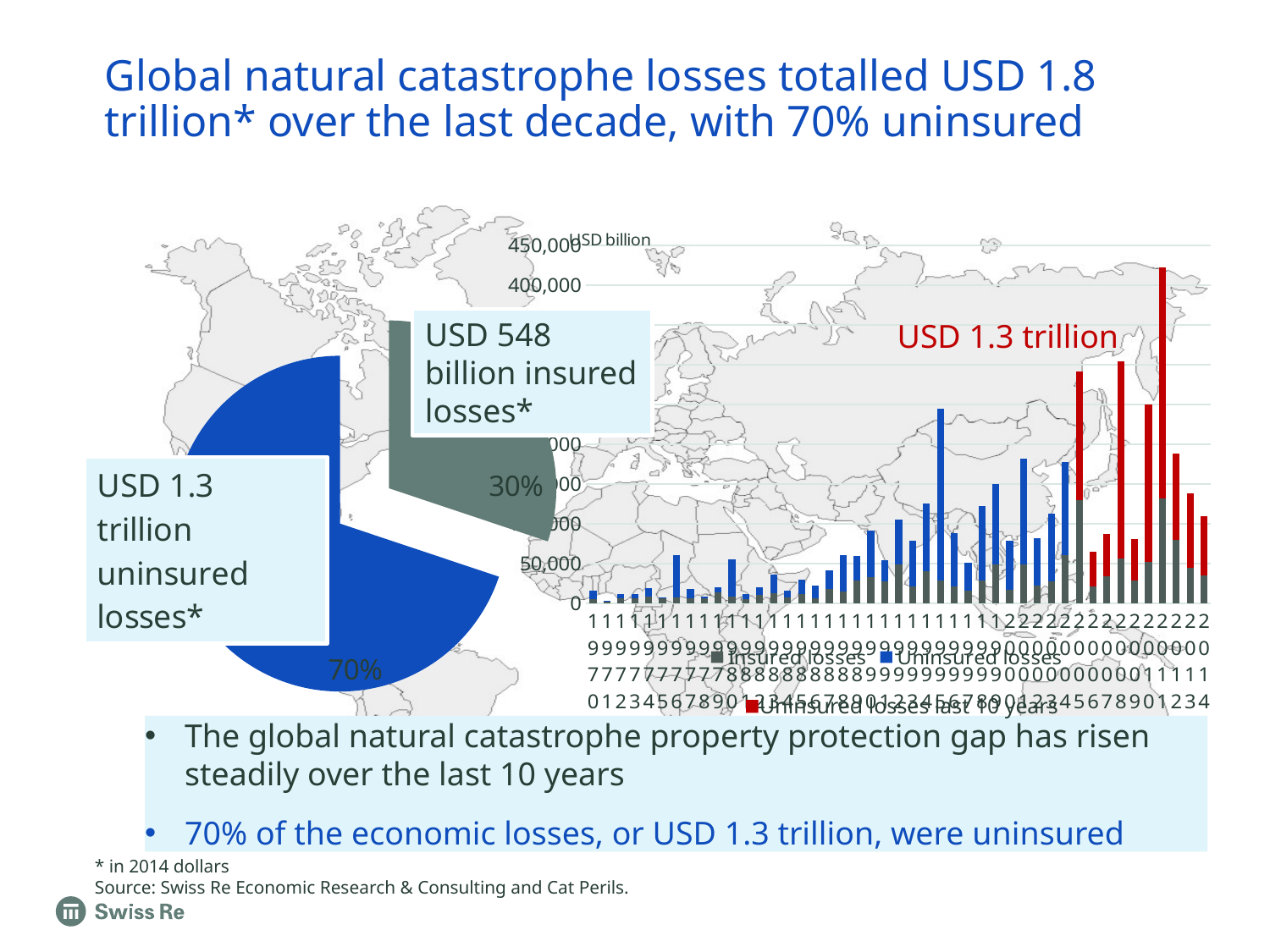
In the bar chart on the right, is the tallest bar greater or less than 400,000? greater What kind of chart is the chart on the left of the slide? pie chart In the pie chart, what share of losses is insured? 30% In the pie chart, what share of losses is uninsured? 70% How many slices does the pie chart have? 2 How many series does the legend of the bar chart on the right list? 3 What unit is shown at the top of the y axis of the bar chart on the right? USD billion In the pie chart, which slice is larger, the insured losses slice or the uninsured losses slice? uninsured losses According to the callout on the pie chart, what is the value of insured losses? USD 548 billion According to the callout on the pie chart, what is the value of uninsured losses? USD 1.3 trillion In the bar chart on the right, do the bar heights generally rise or fall from left to right along the x axis? rise What kind of chart is the chart on the right of the slide? bar chart